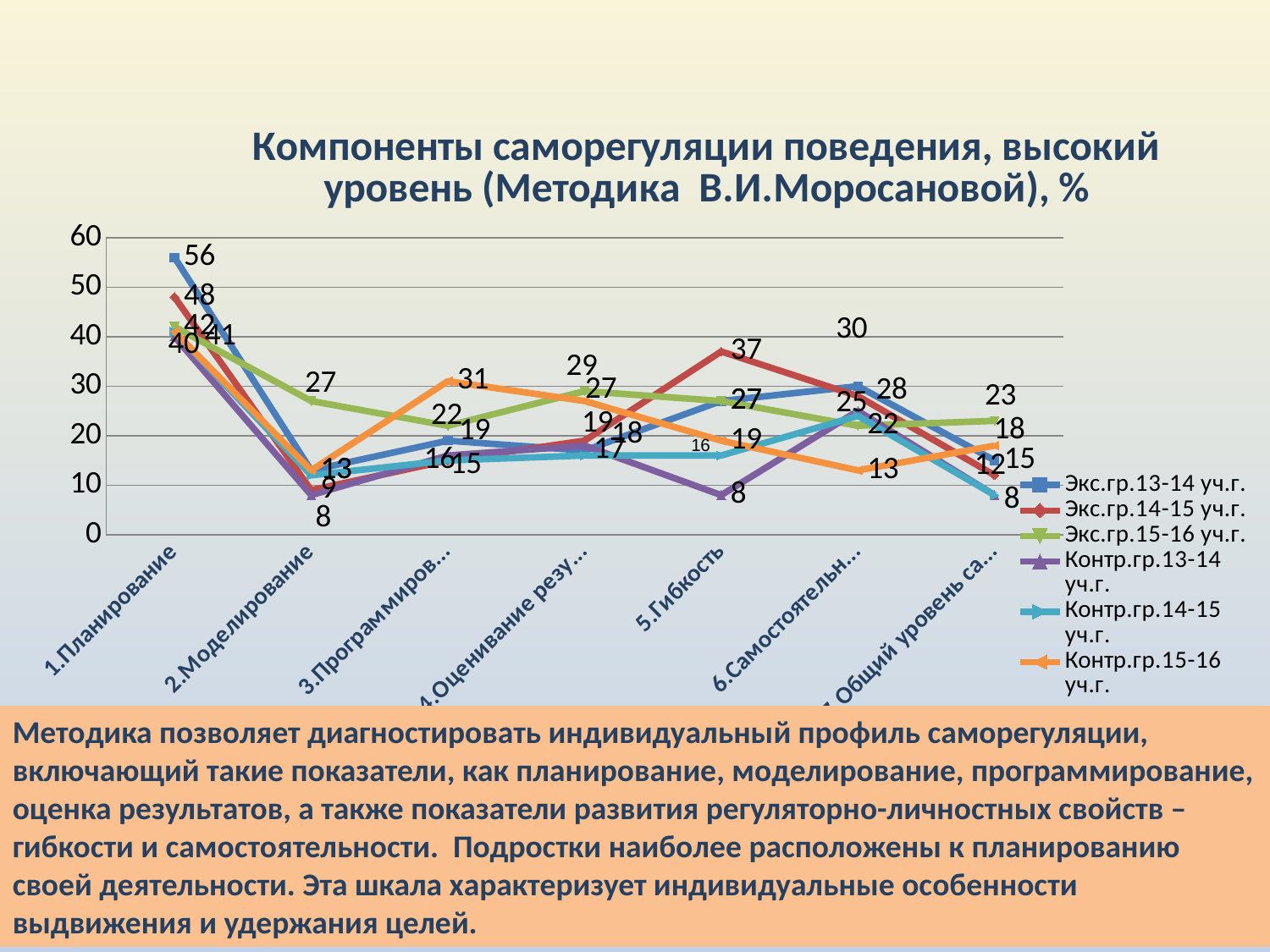
What is the value for Контр.гр.15-16 уч.г. at 6.Самостоятельность? 13 How many series does the legend list? 6 What is the value for Экс.гр.14-15 уч.г. at 5.Гибкость? 37 How many categories are shown on the x axis? 7 At which category does the Экс.гр.13-14 уч.г. series reach its highest value? 1.Планирование At 5.Гибкость, which is larger: Экс.гр.14-15 уч.г. or Контр.гр.13-14 уч.г.? Экс.гр.14-15 уч.г. What is the difference between Экс.гр.13-14 уч.г. and Экс.гр.14-15 уч.г. at 1.Планирование? 8 Which series has the lowest value at 5.Гибкость? Контр.гр.13-14 уч.г. What is the value for Экс.гр.15-16 уч.г. at 2.Моделирование? 27 What kind of chart is shown on the slide? line chart What is the value for Экс.гр.13-14 уч.г. at 1.Планирование? 56 Is the value for Экс.гр.13-14 уч.г. at 1.Планирование greater or less than 50? greater